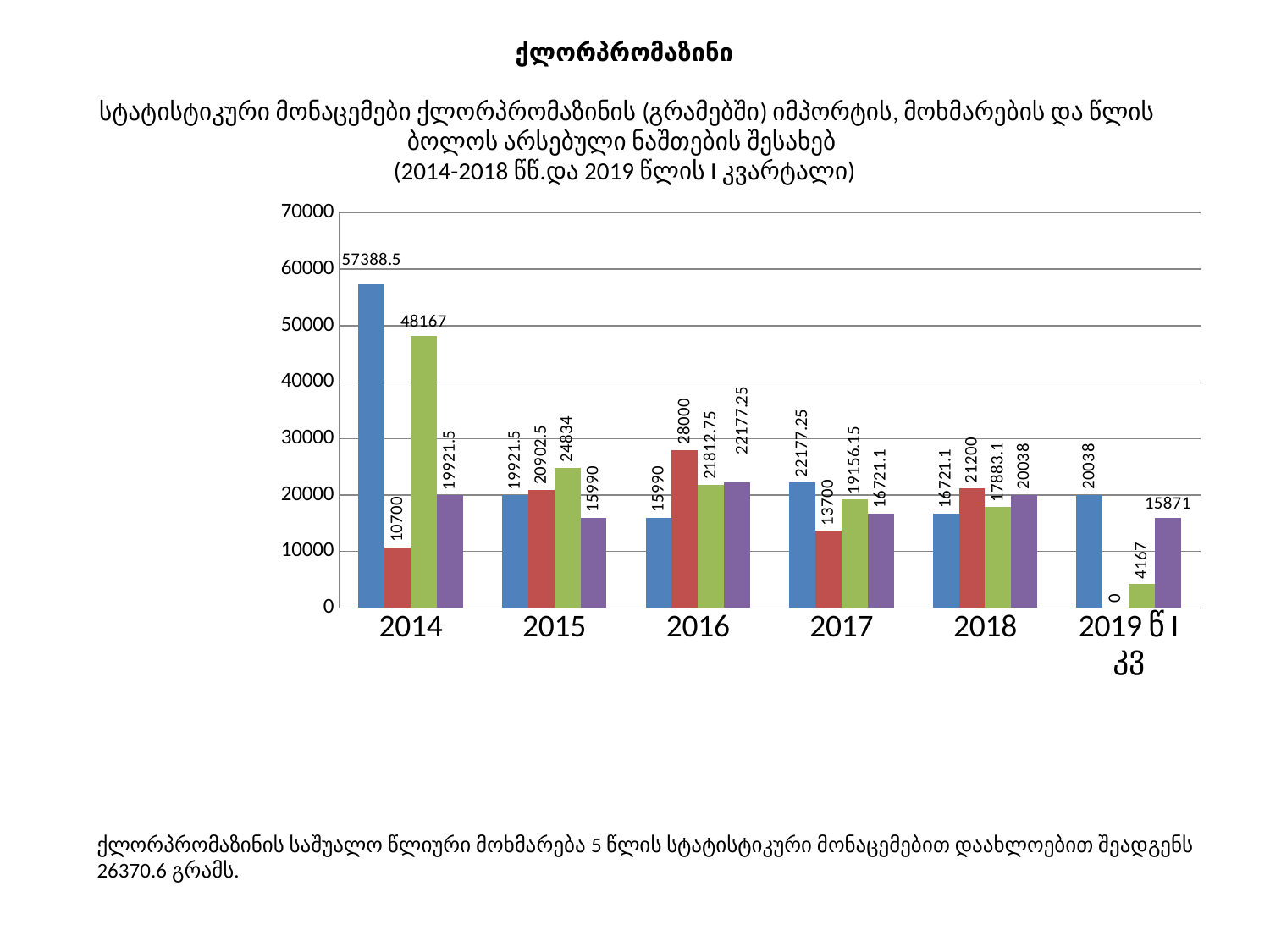
What type of chart is shown on the slide? bar chart What is the value of the red bar for 2016? 28000 How many year categories are shown on the x axis of the chart? 6 Which is larger for 2015, the red bar or the green bar? the green bar What is the value of the blue bar for 2014? 57388.5 Is the value of the green bar for 2014 greater or less than 40000? greater What is the value of the purple bar for 2018? 20038 What is the difference between the blue bar and the green bar for 2014? 9221.5 How many bars are shown for each year category? 4 Which year has the tallest bar in the chart? 2014 Which year has the lowest red bar? 2019 წ I კვ What is the value of the green bar for 2019 წ I კვ? 4167